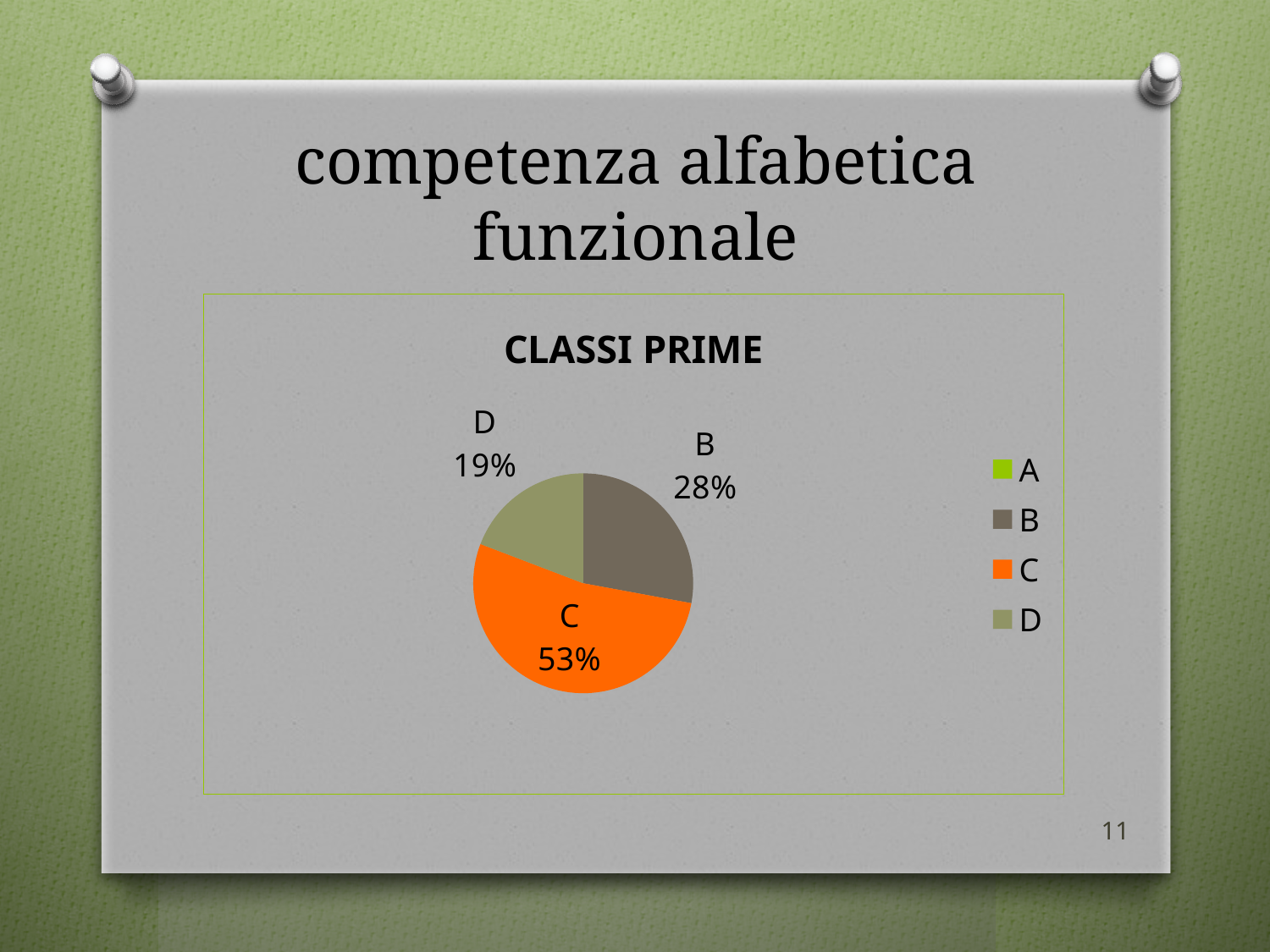
What is the difference in percentage points between slice C and slice B? 25 How many entries does the legend list? 4 Which labelled slice is the smallest in the pie chart? D What percentage does slice D represent in the pie chart? 19% What percentage does slice C represent in the pie chart? 53% What is the title of the chart? CLASSI PRIME What kind of chart is shown on the slide? pie chart What colour is slice C in the pie chart? orange What percentage does slice B represent in the pie chart? 28% What is the combined share of slices B and D? 47% Which slice is the largest in the pie chart? C Which is larger, slice B or slice D? B